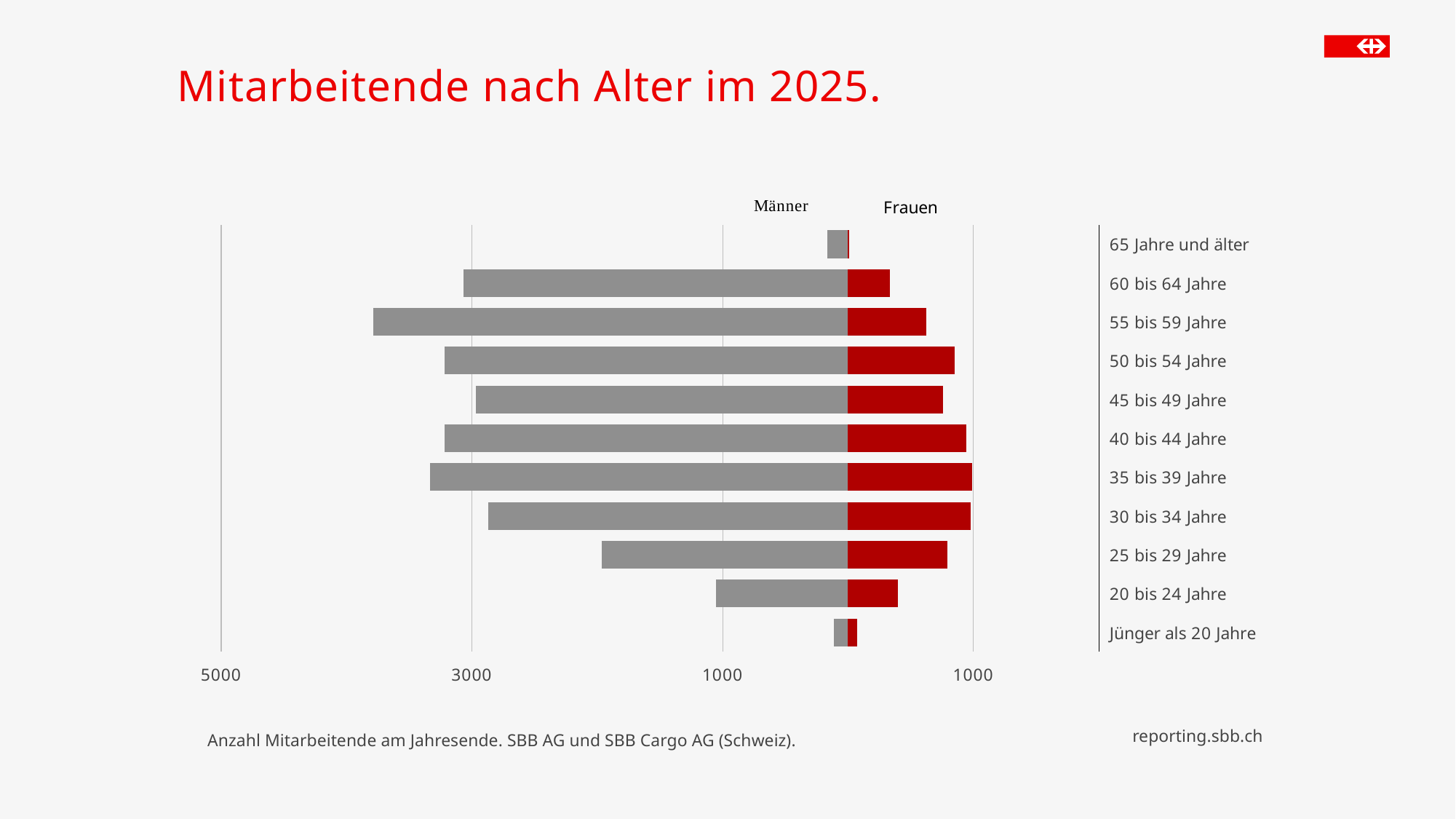
Is the Männer value for 55 bis 59 Jahre greater or less than 3000? greater How many series does the chart show? 2 What kind of chart is shown on the slide? bar chart Is the Frauen value for 60 bis 64 Jahre greater or less than 1000? less Which colour represents the Frauen series? red Which is larger for Männer: 55 bis 59 Jahre or 60 bis 64 Jahre? 55 bis 59 Jahre Which age category has the highest value for Männer? 55 bis 59 Jahre Which is larger for Frauen: 50 bis 54 Jahre or 20 bis 24 Jahre? 50 bis 54 Jahre For 40 bis 44 Jahre, which series has the larger value, Männer or Frauen? Männer How many age categories are shown in the chart? 11 What is the title of the chart? Mitarbeitende nach Alter im 2025. Is the Männer value for 25 bis 29 Jahre greater or less than 1000? greater